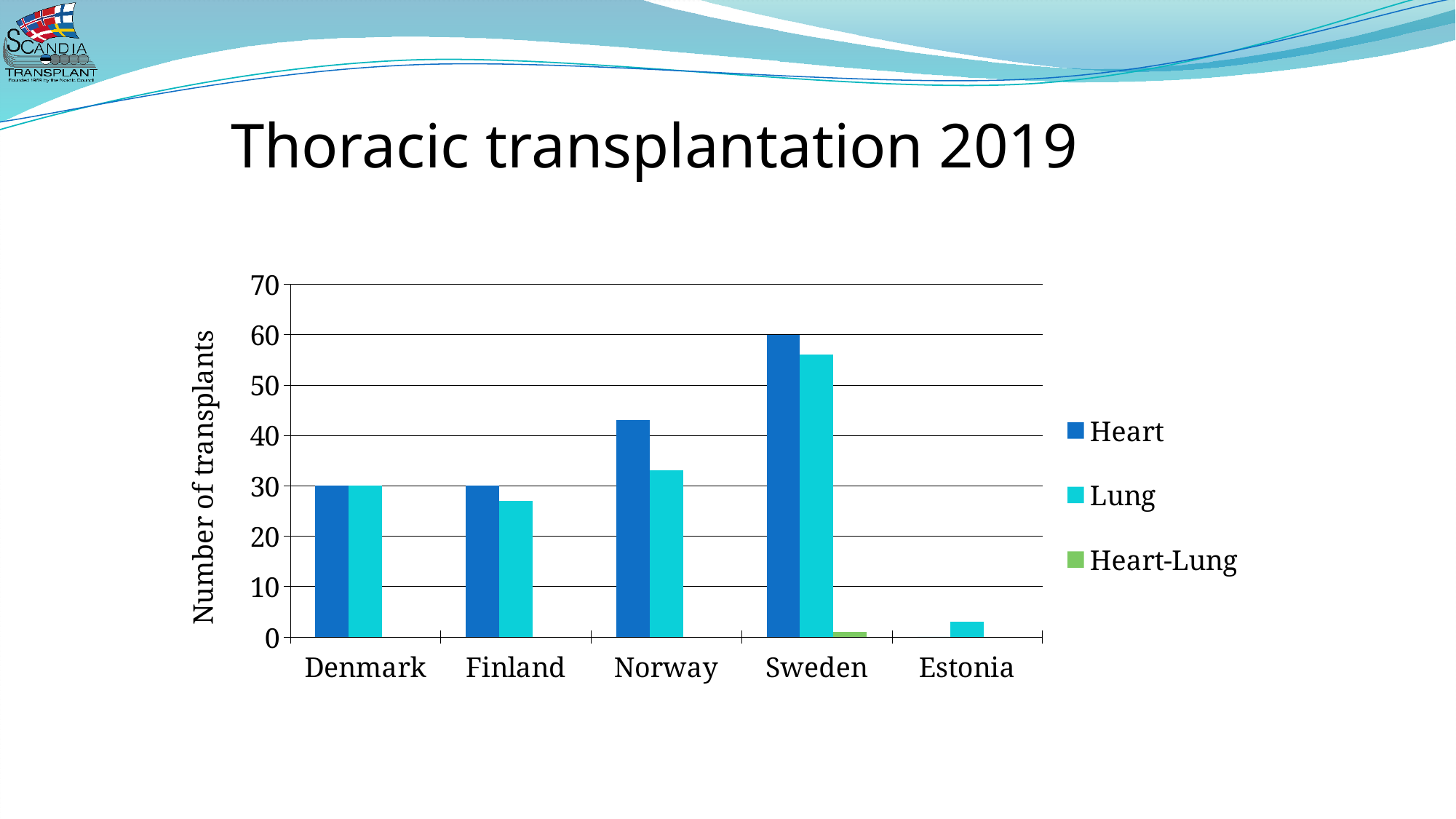
How many countries are shown on the x axis of the chart? 5 What is the number of Heart transplants for Denmark? 30 Is the number of Lung transplants for Norway greater or less than 30? greater What is the title of the chart slide? Thoracic transplantation 2019 What is the number of Heart transplants for Sweden? 60 Which country has the highest number of Heart transplants? Sweden How many series does the chart legend list? 3 What type of chart is shown on the slide? bar chart Which country has the lowest number of Lung transplants? Estonia Which is larger for Norway, the Heart value or the Lung value? Heart Is the number of Lung transplants for Finland greater or less than 30? less What is the number of Lung transplants for Denmark? 30